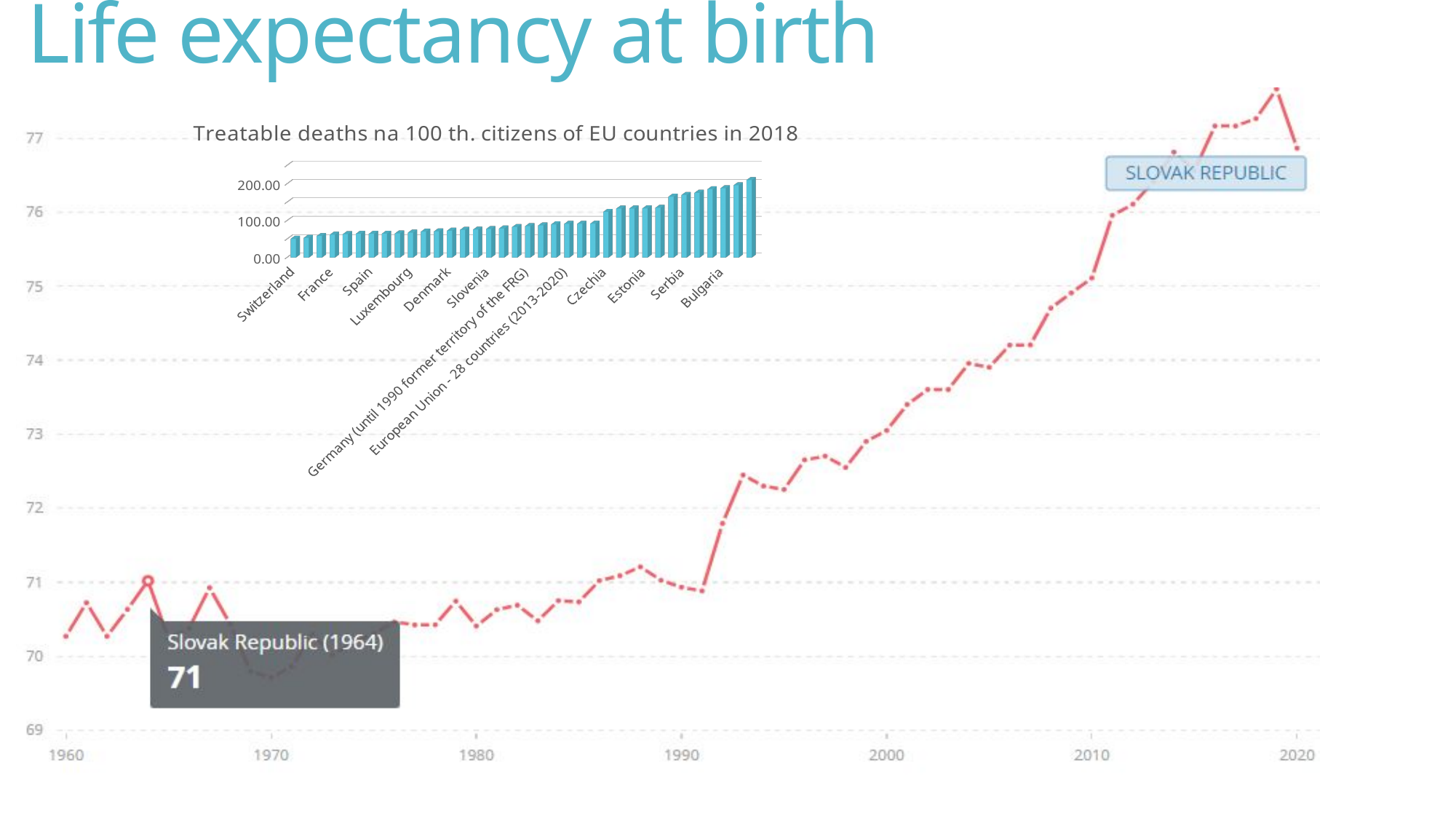
On the treatable deaths bar chart, is the value for Switzerland greater or less than 100.00? less On the life expectancy line chart, is the value for 2019 greater or less than 77? greater On the life expectancy line chart, is the value for 1960 greater or less than 71? less Which country is named in the label box on the life expectancy line chart? SLOVAK REPUBLIC On the treatable deaths bar chart, which has the larger value, Switzerland or Serbia? Serbia What kind of chart is the large chart showing life expectancy at birth? line chart What kind of chart is the inset chart titled 'Treatable deaths na 100 th. citizens of EU countries in 2018'? bar chart On the life expectancy line chart, do the values generally rise or fall from 1960 to 2020? rise On the life expectancy line chart, what is the value for the Slovak Republic in 1964 shown in the tooltip? 71 On the treatable deaths bar chart, which has the larger value, Czechia or France? Czechia